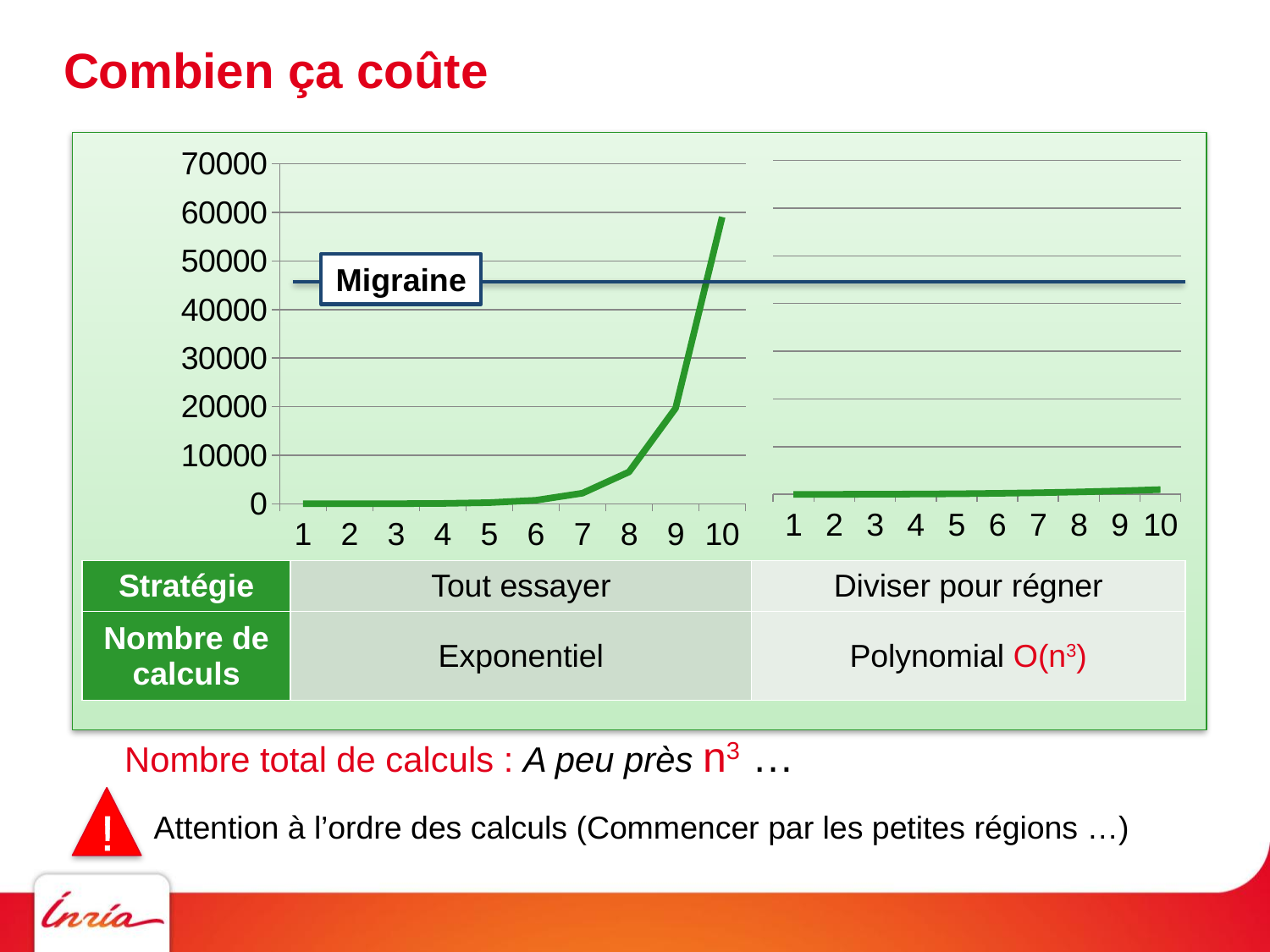
What kind of chart is the left chart (Tout essayer)? line chart In the left chart (Tout essayer), is the value at x = 10 greater or less than 50000? greater In the right chart (Diviser pour régner), is the value at x = 10 greater or less than 10000? less In the left chart (Tout essayer), do the values rise or fall as x goes from 1 to 10? rise In the left chart (Tout essayer), how many points are plotted along the x axis? 10 Which is larger at x = 10: the value in the left chart (Tout essayer) or the value in the right chart (Diviser pour régner)? Tout essayer In the right chart (Diviser pour régner), how many x-axis categories are shown? 10 What is the highest value shown on the y axis of the charts? 70000 What label is attached to the horizontal line drawn across the charts? Migraine In the left chart (Tout essayer), is the value at x = 8 greater or less than 10000? less What kind of chart is the right chart (Diviser pour régner)? line chart